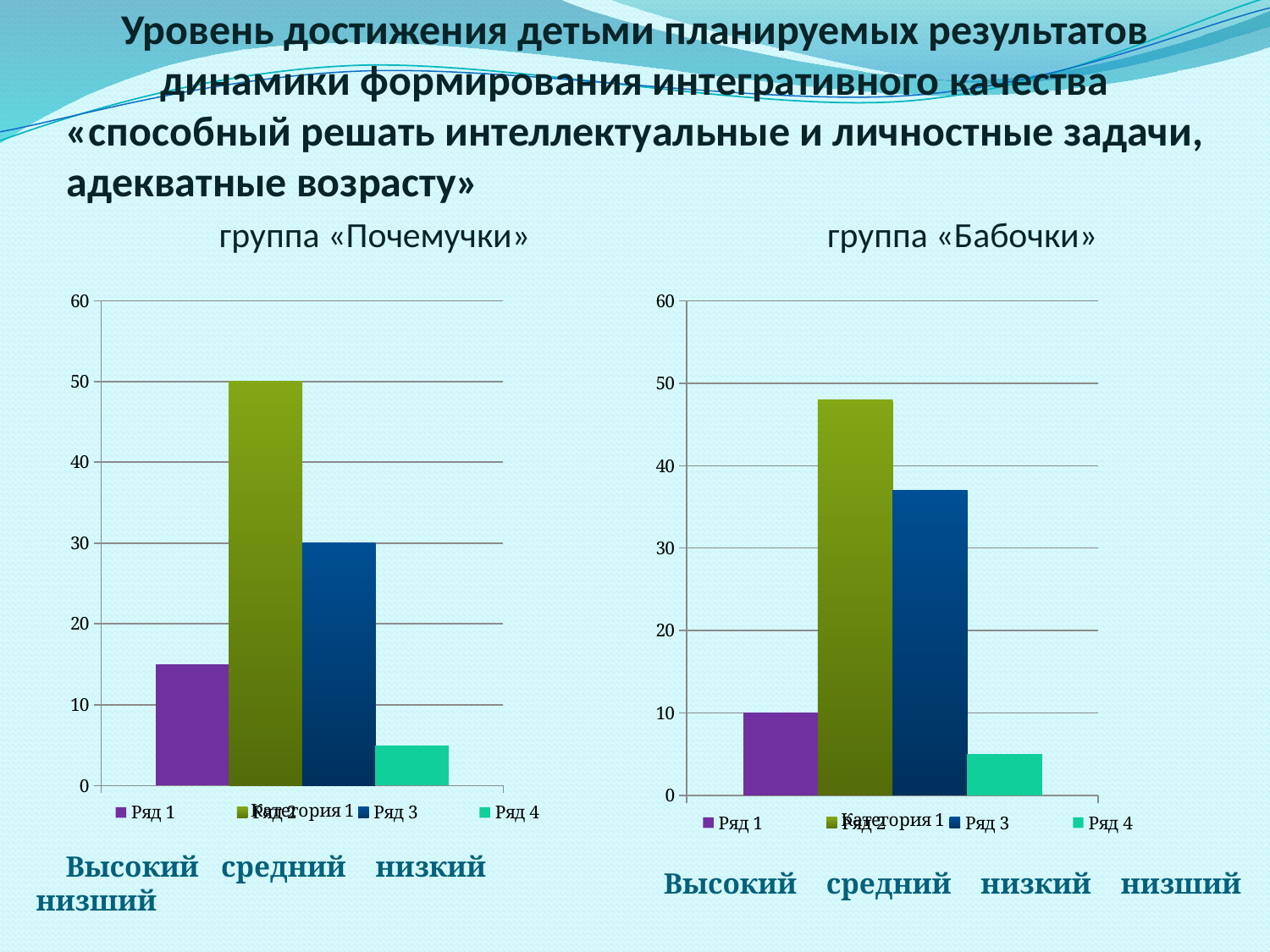
In the chart for группа «Почемучки», is the value for Ряд 1 greater or less than 10? greater In the chart for группа «Бабочки», is the value for Ряд 3 greater or less than 40? less In the chart for группа «Бабочки», which series has the lowest bar? Ряд 4 In the chart for группа «Бабочки», which is larger, the value for Ряд 2 or the value for Ряд 3? Ряд 2 What is the maximum value shown on the vertical axis of the chart for группа «Бабочки»? 60 In the chart for группа «Почемучки», what is the value for Ряд 2? 50 In the chart for группа «Почемучки», what is the difference between the values for Ряд 2 and Ряд 3? 20 How many series does the legend of the chart for группа «Бабочки» list? 4 What kind of chart is used for группа «Почемучки»? bar chart In the chart for группа «Почемучки», what is the value for Ряд 3? 30 In the chart for группа «Почемучки», which series has the highest bar? Ряд 2 In the chart for группа «Бабочки», what is the value for Ряд 1? 10